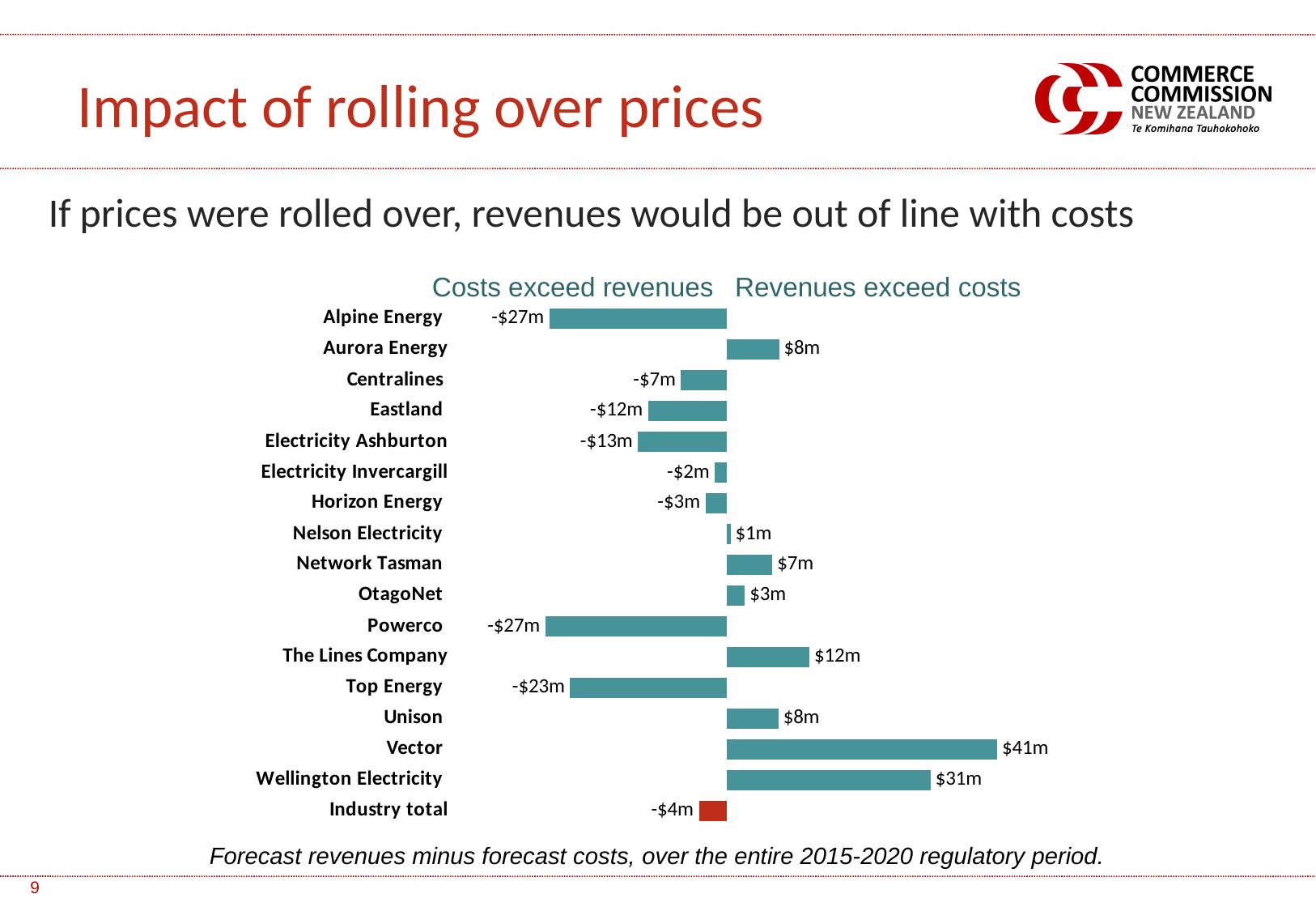
What is the value shown for Top Energy? -$23m What kind of chart is shown on the slide? Bar chart What is the difference between the values for Alpine Energy and Top Energy? $4m What is the value shown for Industry total? -$4m Which category has the highest value? Vector Which is larger, the value for The Lines Company or the value for Network Tasman? The Lines Company Which is larger, the value for Eastland or the value for Horizon Energy? Horizon Energy What is the value shown for Electricity Ashburton? -$13m What is the difference between the values for Vector and Wellington Electricity? $10m What is the value shown for Vector? $41m How many categories (bars) are shown in the chart, including Industry total? 17 Which bar is drawn in a different colour (red) from the others? Industry total